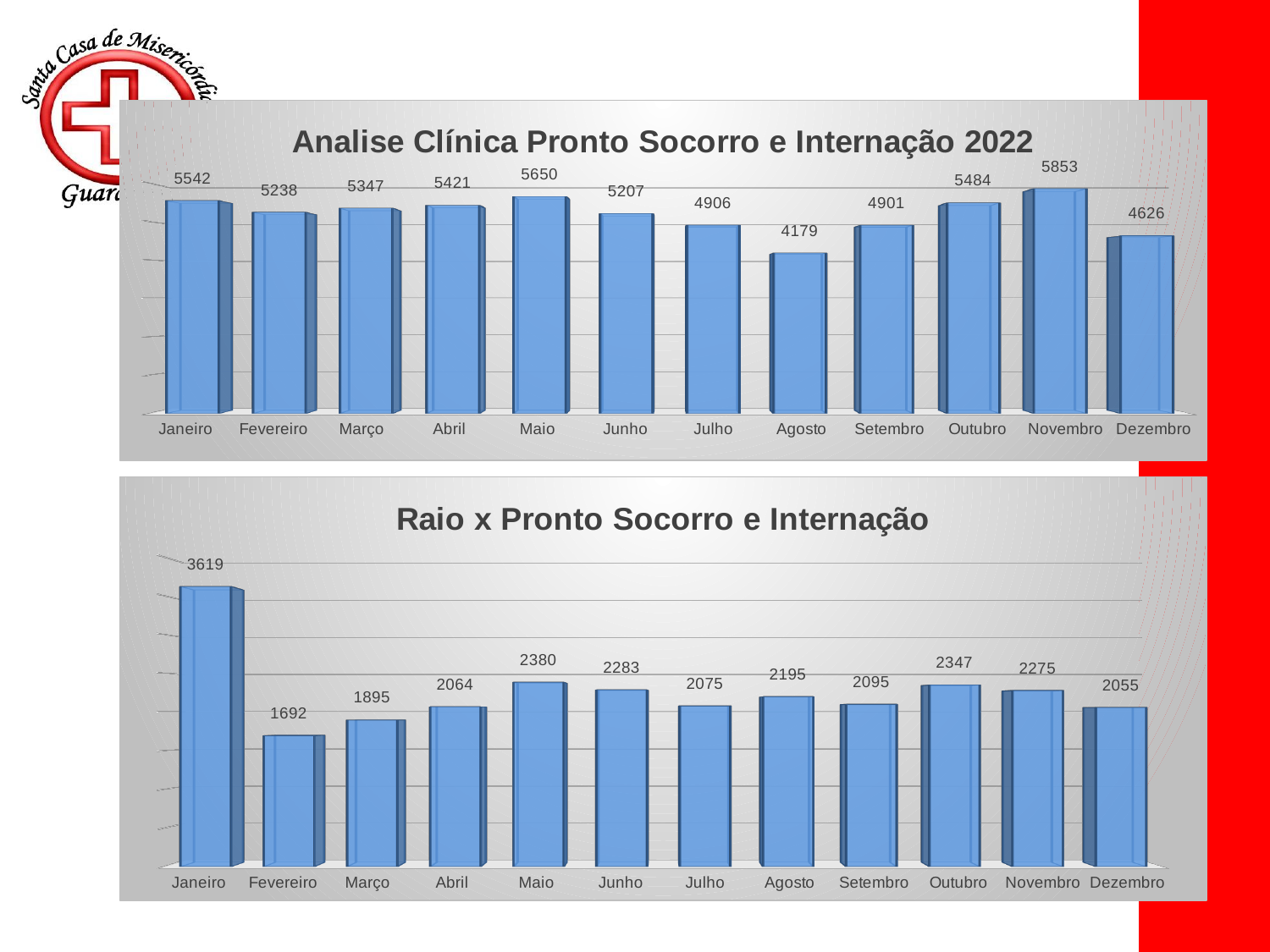
How many months are shown in the 'Analise Clínica Pronto Socorro e Internação 2022' chart? 12 In the 'Analise Clínica Pronto Socorro e Internação 2022' chart, which month has the highest value? Novembro In the 'Raio x Pronto Socorro e Internação' chart, which is larger, the value for Maio or the value for Junho? Maio In the 'Raio x Pronto Socorro e Internação' chart, which month has the lowest value? Fevereiro In the 'Raio x Pronto Socorro e Internação' chart, what is the value for Outubro? 2347 In the 'Analise Clínica Pronto Socorro e Internação 2022' chart, what is the difference between the values for Novembro and Agosto? 1674 In the 'Raio x Pronto Socorro e Internação' chart, what is the difference between the values for Janeiro and Fevereiro? 1927 In the 'Analise Clínica Pronto Socorro e Internação 2022' chart, which is larger, the value for Janeiro or the value for Dezembro? Janeiro What kind of chart is 'Raio x Pronto Socorro e Internação'? Bar chart In the 'Analise Clínica Pronto Socorro e Internação 2022' chart, which month has the lowest value? Agosto In the 'Analise Clínica Pronto Socorro e Internação 2022' chart, what is the value for Maio? 5650 In the 'Raio x Pronto Socorro e Internação' chart, what is the value for Janeiro? 3619